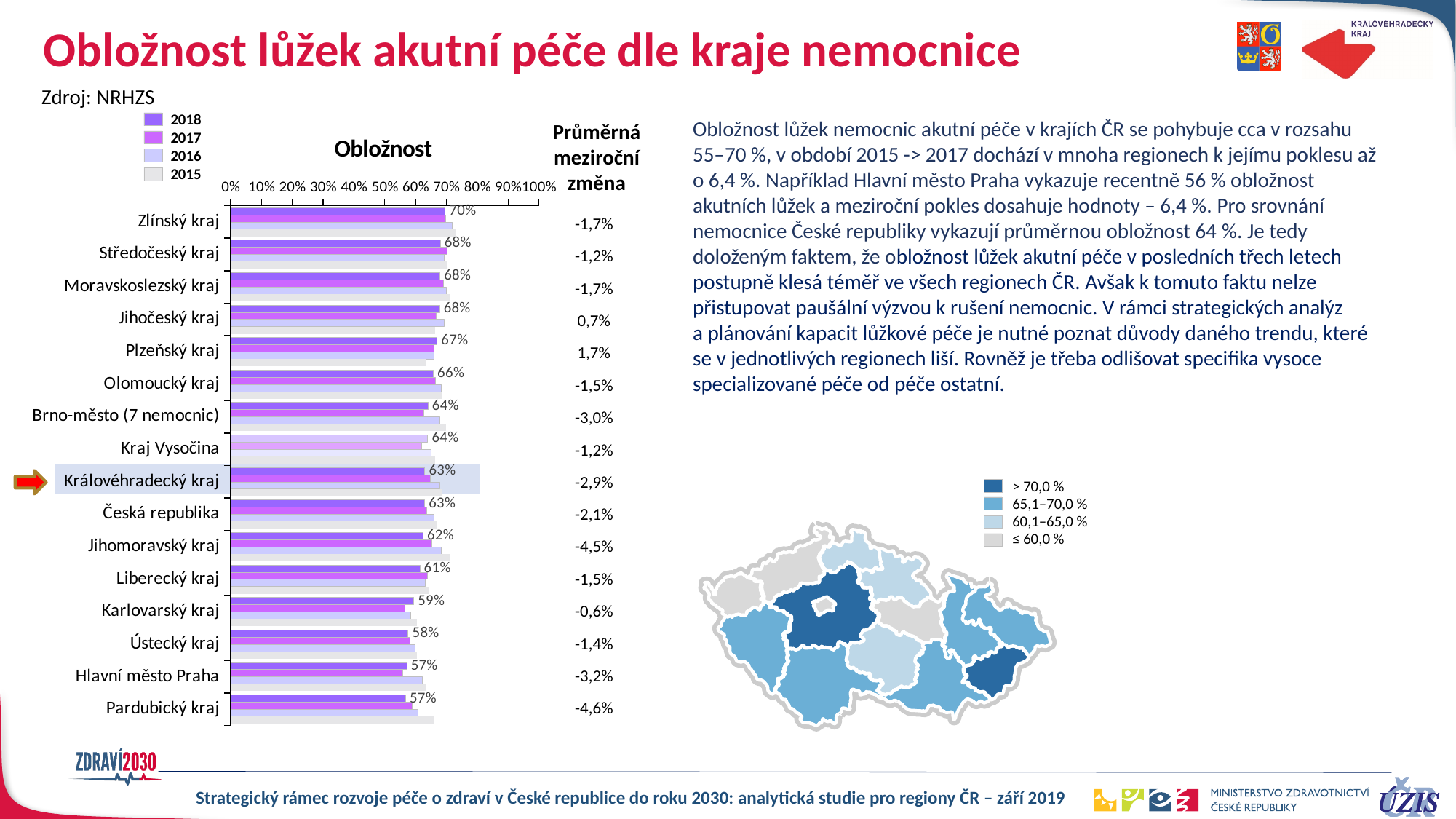
What is the difference between the labelled values for Zlínský kraj and Pardubický kraj in the Obložnost chart? 13 percentage points What is the title of the bar chart on the slide? Obložnost How many categories (rows) are plotted in the Obložnost chart? 16 What is the labelled 2018 value for Zlínský kraj in the Obložnost chart? 70% Is the 2018 bar for Zlínský kraj in the Obložnost chart greater or less than 60%? greater Which category has the highest labelled value in the Obložnost chart? Zlínský kraj What is the labelled 2018 value for Hlavní město Praha in the Obložnost chart? 57% How many series does the legend of the Obložnost chart list? 4 What kind of chart is shown on the slide? bar chart What is the labelled 2018 value for Královéhradecký kraj in the Obložnost chart? 63% Which has the larger labelled value in the Obložnost chart, Plzeňský kraj or Liberecký kraj? Plzeňský kraj What is the Průměrná meziroční změna value shown for Pardubický kraj? -4,6%